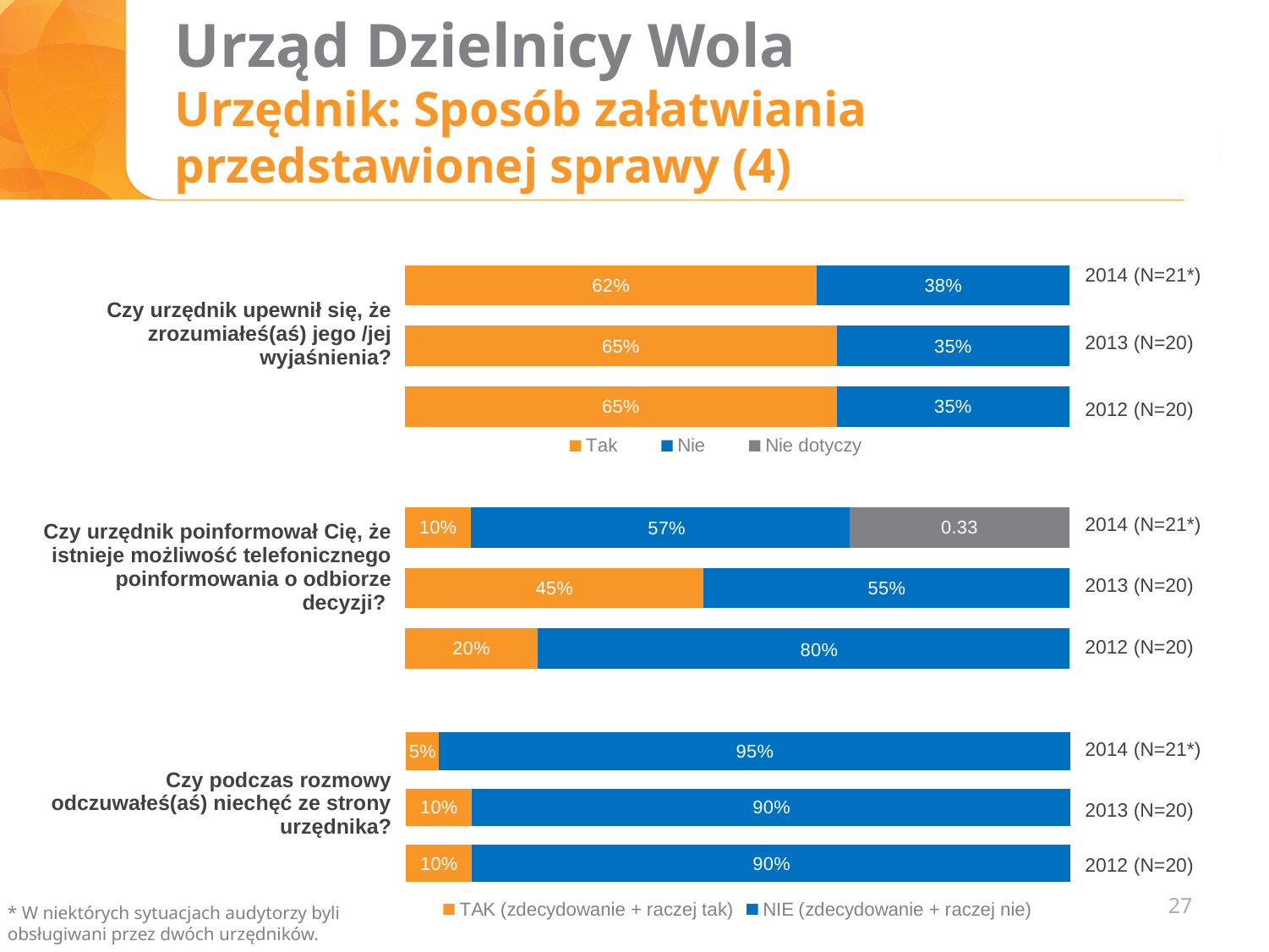
In the top chart ("Czy urzędnik upewnił się, że zrozumiałeś(aś) jego /jej wyjaśnienia?"), what is the "Nie" value for 2013 (N=20)? 35% In the middle chart ("Czy urzędnik poinformował Cię, że istnieje możliwość telefonicznego poinformowania o odbiorze decyzji?"), which year has the highest "Tak" value? 2013 (N=20) In the top chart ("Czy urzędnik upewnił się, że zrozumiałeś(aś) jego /jej wyjaśnienia?"), what is the "Tak" value for 2014 (N=21*)? 62% What type of chart is the bottom chart ("Czy podczas rozmowy odczuwałeś(aś) niechęć ze strony urzędnika?")? Stacked bar chart In the middle chart ("Czy urzędnik poinformował Cię, że istnieje możliwość telefonicznego poinformowania o odbiorze decyzji?"), which is larger: the "Nie" value for 2013 (N=20) or the "Nie" value for 2012 (N=20)? 2012 (N=20) In the bottom chart ("Czy podczas rozmowy odczuwałeś(aś) niechęć ze strony urzędnika?"), what is the "NIE (zdecydowanie + raczej nie)" value for 2014 (N=21*)? 95% In the top chart ("Czy urzędnik upewnił się, że zrozumiałeś(aś) jego /jej wyjaśnienia?"), how many series does the legend list? 3 In the middle chart ("Czy urzędnik poinformował Cię, że istnieje możliwość telefonicznego poinformowania o odbiorze decyzji?"), what is the "Nie dotyczy" value for 2014 (N=21*)? 0.33 In the bottom chart ("Czy podczas rozmowy odczuwałeś(aś) niechęć ze strony urzędnika?"), which year has the lowest "TAK (zdecydowanie + raczej tak)" value? 2014 (N=21*) In the middle chart ("Czy urzędnik poinformował Cię, że istnieje możliwość telefonicznego poinformowania o odbiorze decyzji?"), what is the "Nie" value for 2012 (N=20)? 80% In the top chart ("Czy urzędnik upewnił się, że zrozumiałeś(aś) jego /jej wyjaśnienia?"), what is the difference between the "Tak" value for 2013 (N=20) and the "Tak" value for 2014 (N=21*)? 3 percentage points In the bottom chart ("Czy podczas rozmowy odczuwałeś(aś) niechęć ze strony urzędnika?"), how many years (bars) are shown? 3